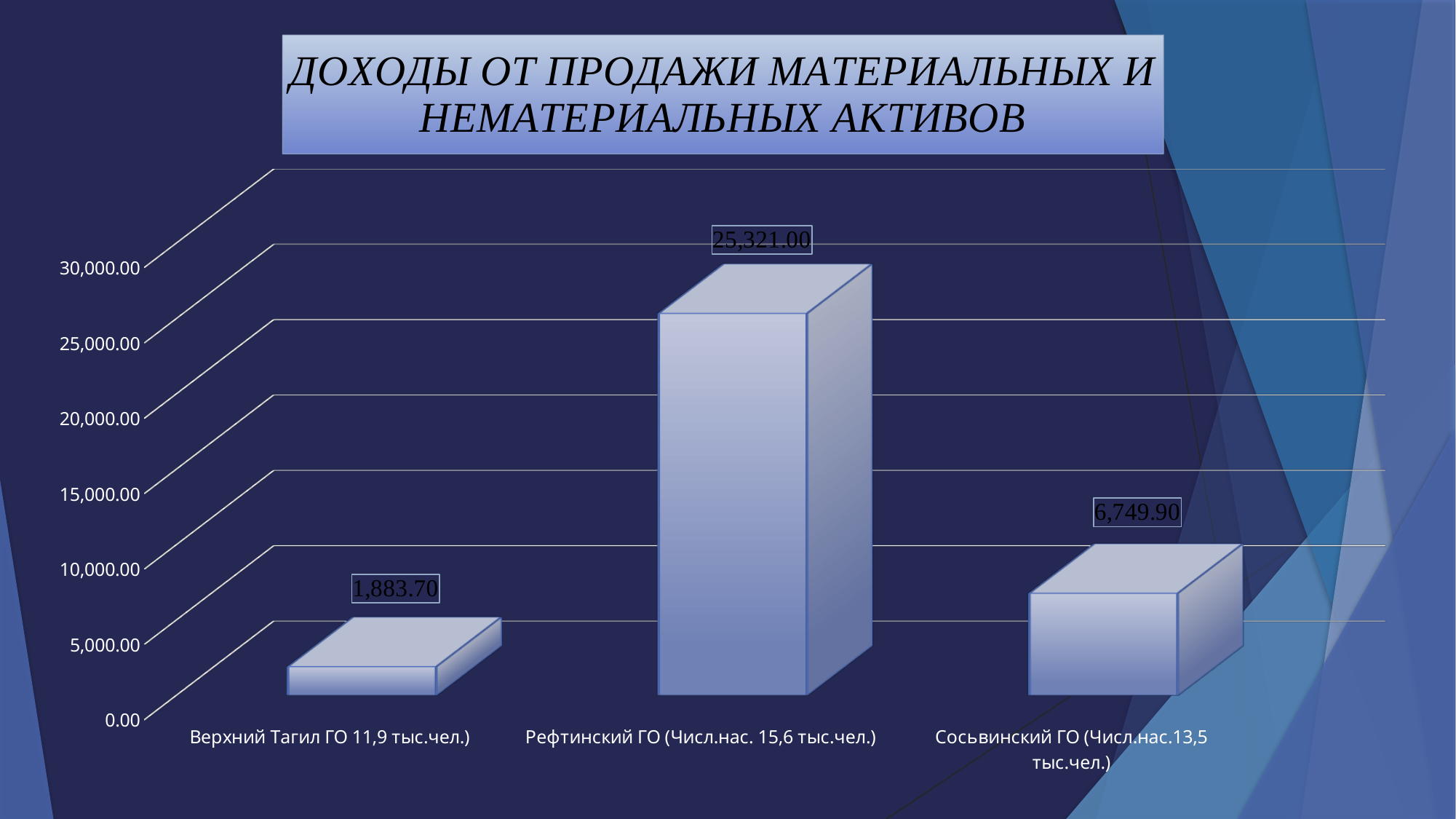
What is the value for Верхний Тагил ГО? 1,883.70 What is the value for Рефтинский ГО? 25,321.00 Which category has the lowest value? Верхний Тагил ГО Which is larger, the value for Сосьвинский ГО or the value for Верхний Тагил ГО? Сосьвинский ГО Which category has the highest value? Рефтинский ГО What is the title of the chart? ДОХОДЫ ОТ ПРОДАЖИ МАТЕРИАЛЬНЫХ И НЕМАТЕРИАЛЬНЫХ АКТИВОВ What is the value for Сосьвинский ГО? 6,749.90 What is the difference between the values for Рефтинский ГО and Сосьвинский ГО? 18,571.10 What kind of chart is shown on the slide? bar chart How many categories are shown in the chart? 3 Is the value for Рефтинский ГО greater or less than 20,000.00? greater What is the difference between the values for Сосьвинский ГО and Верхний Тагил ГО? 4,866.20